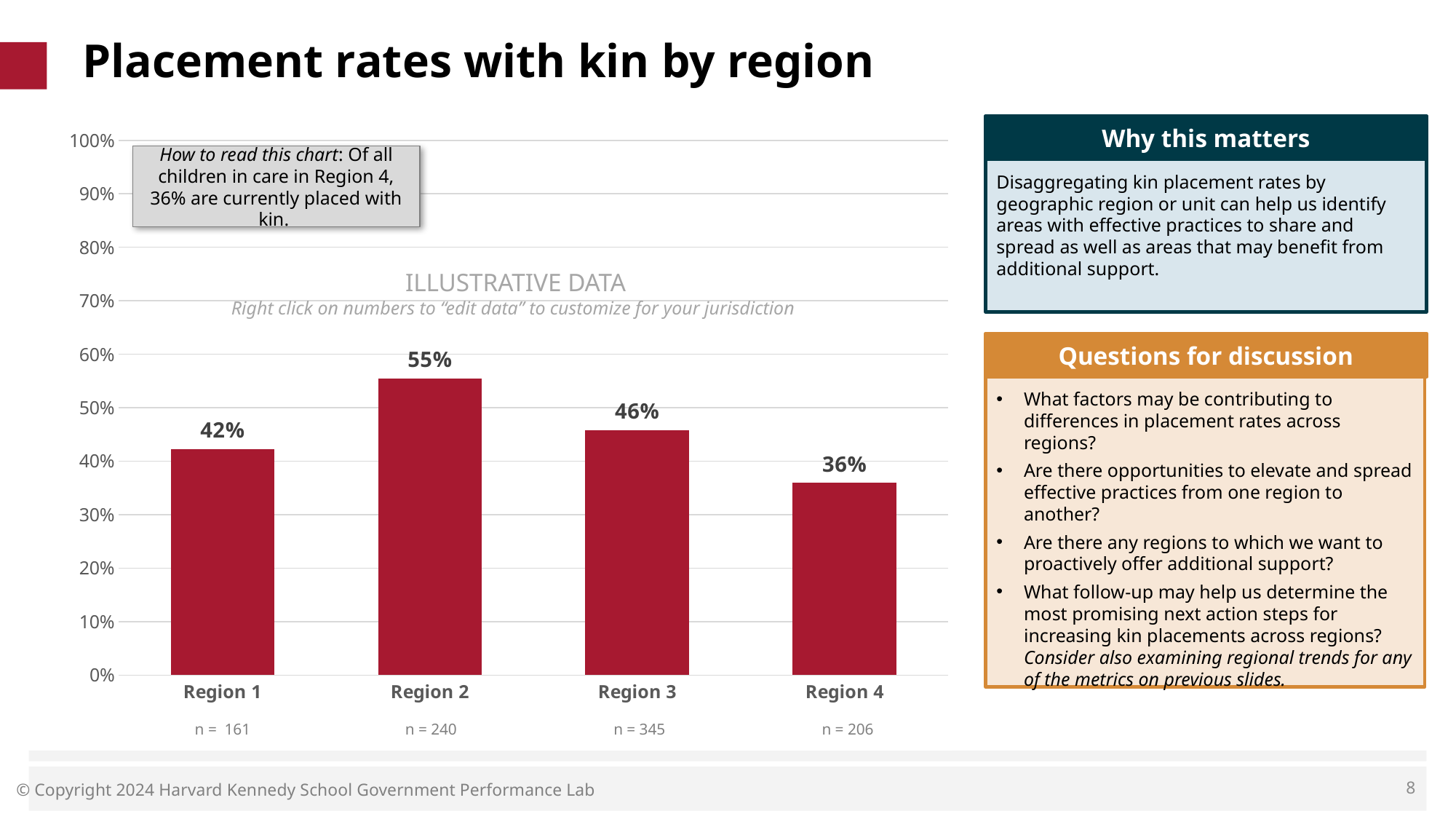
What is the difference in placement rate between Region 3 and Region 1? 4% Which region has the lowest placement rate with kin? Region 4 What is the sample size (n) shown for Region 3? n = 345 Which region has the highest placement rate with kin? Region 2 How many regions are shown in the chart? 4 What is the placement rate with kin for Region 4? 36% Which has a higher placement rate with kin, Region 1 or Region 3? Region 3 What is the placement rate with kin for Region 1? 42% What is the placement rate with kin for Region 2? 55% Is the placement rate for Region 2 greater or less than 50%? greater What type of chart is used to show placement rates with kin by region? bar chart What is the difference in placement rate between Region 2 and Region 4? 19%